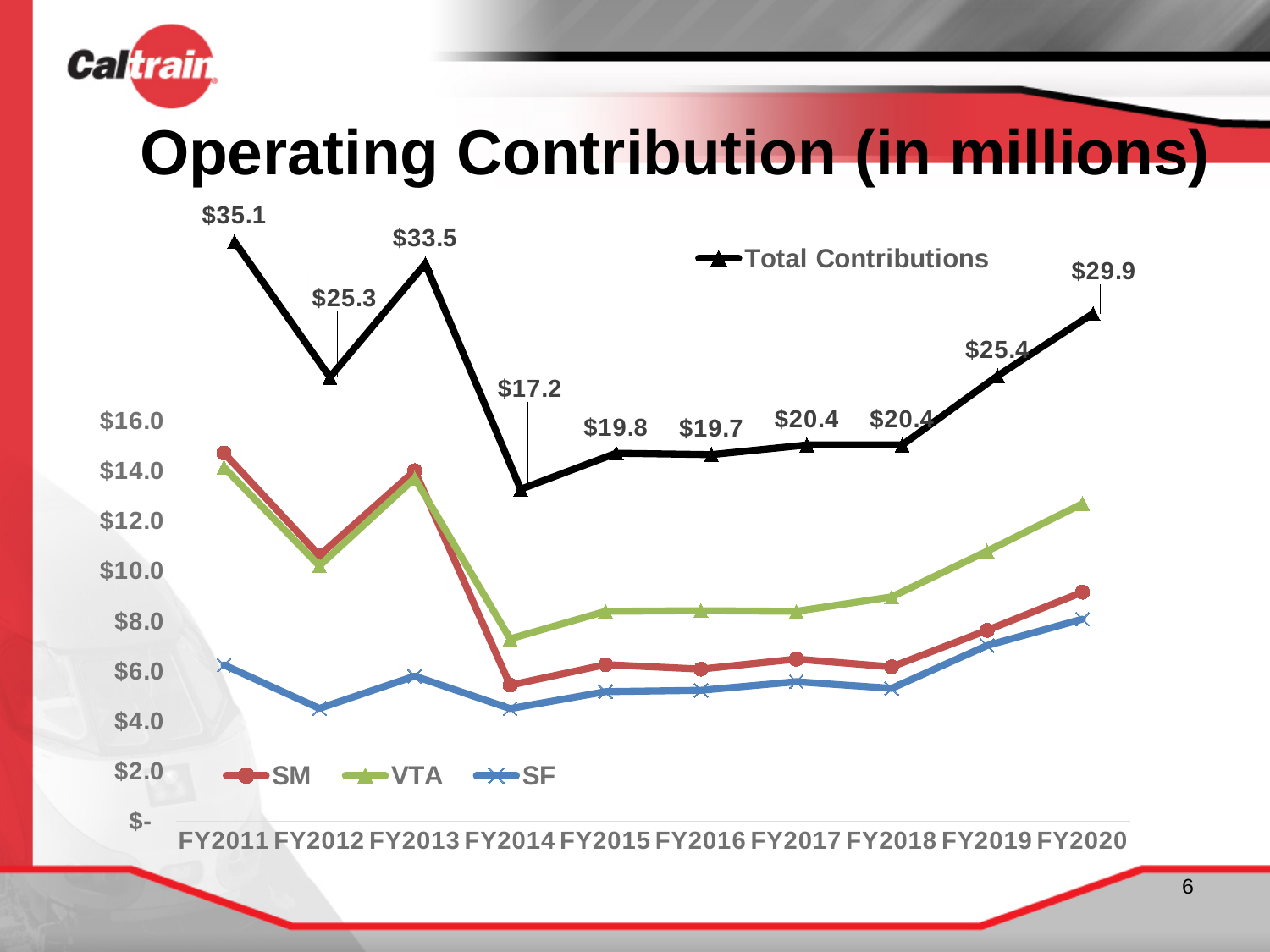
What is the Total Contributions value for FY2011? $35.1 What kind of chart is shown on the slide? line chart What is the difference between Total Contributions in FY2020 and FY2019? $4.5 What is the Total Contributions value for FY2014? $17.2 In which fiscal year is Total Contributions lowest? FY2014 How many series are listed across the chart's legends? 4 How many fiscal years are shown on the x axis? 10 Is the value for SF in FY2011 greater or less than $8.0? less Is the value for VTA in FY2020 greater or less than $10.0? greater In which fiscal year is Total Contributions highest? FY2011 Does Total Contributions rise or fall from FY2018 to FY2020? rise Which year has the larger Total Contributions, FY2012 or FY2013? FY2013